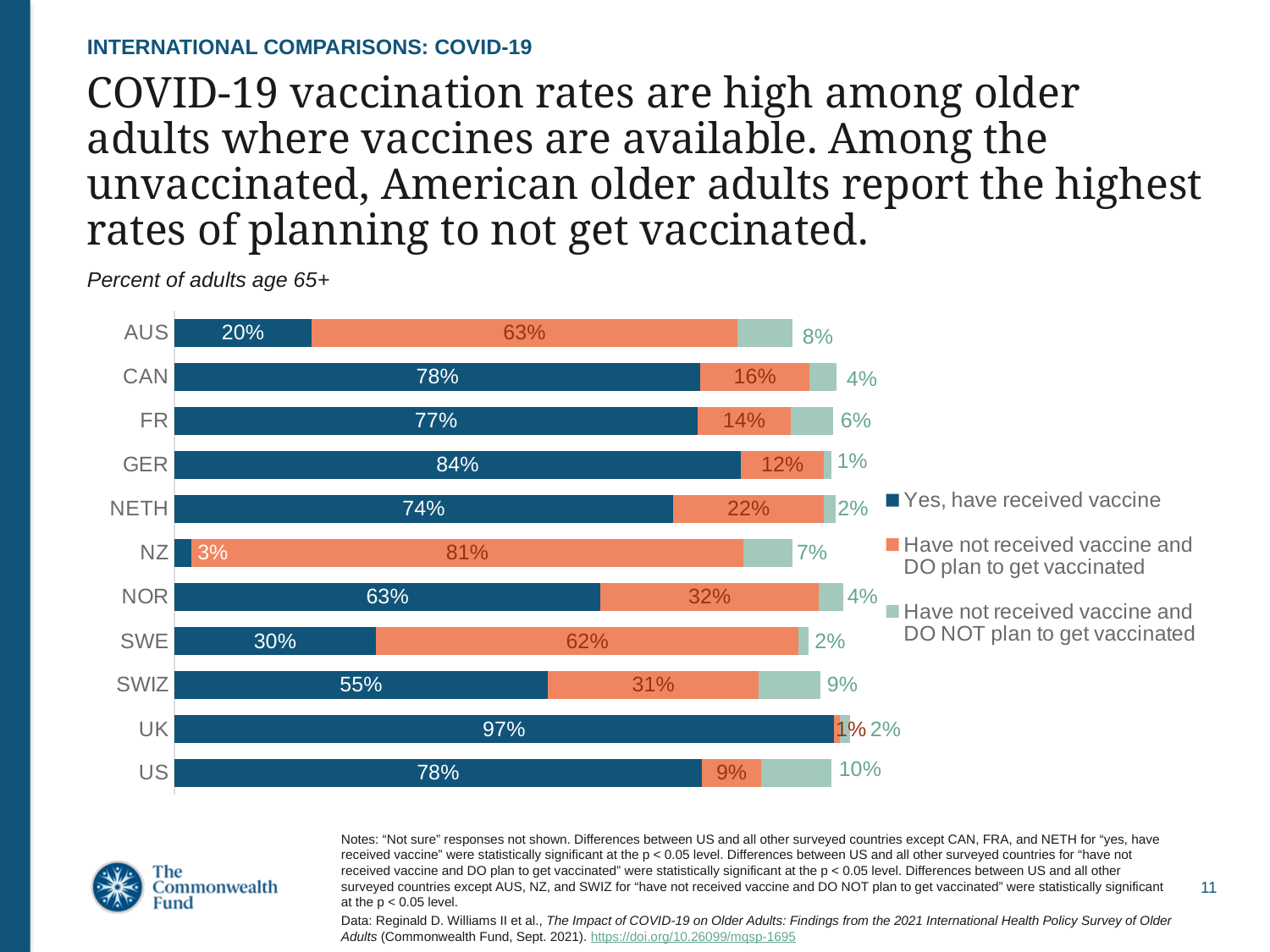
How many countries are shown in the chart? 11 What percentage of adults age 65+ in the US have not received the vaccine and DO NOT plan to get vaccinated? 10% What percentage of adults age 65+ in New Zealand have not received the vaccine and DO plan to get vaccinated? 81% Which country has the lowest percentage of adults age 65+ who have received the vaccine? NZ Which country has a higher percentage of adults age 65+ who have received the vaccine, Norway or Switzerland? Norway What is the difference between the percentage of adults age 65+ who have received the vaccine in the UK and in Sweden? 67 percentage points Which country has the highest percentage of adults age 65+ who have received the vaccine? UK What kind of chart is shown on the slide? Stacked bar chart What percentage of adults age 65+ in Germany have received the vaccine? 84% How many series does the legend list? 3 What is the total of the three segments shown for Australia? 91% Which country has the highest percentage of adults age 65+ who have not received the vaccine and DO NOT plan to get vaccinated? US